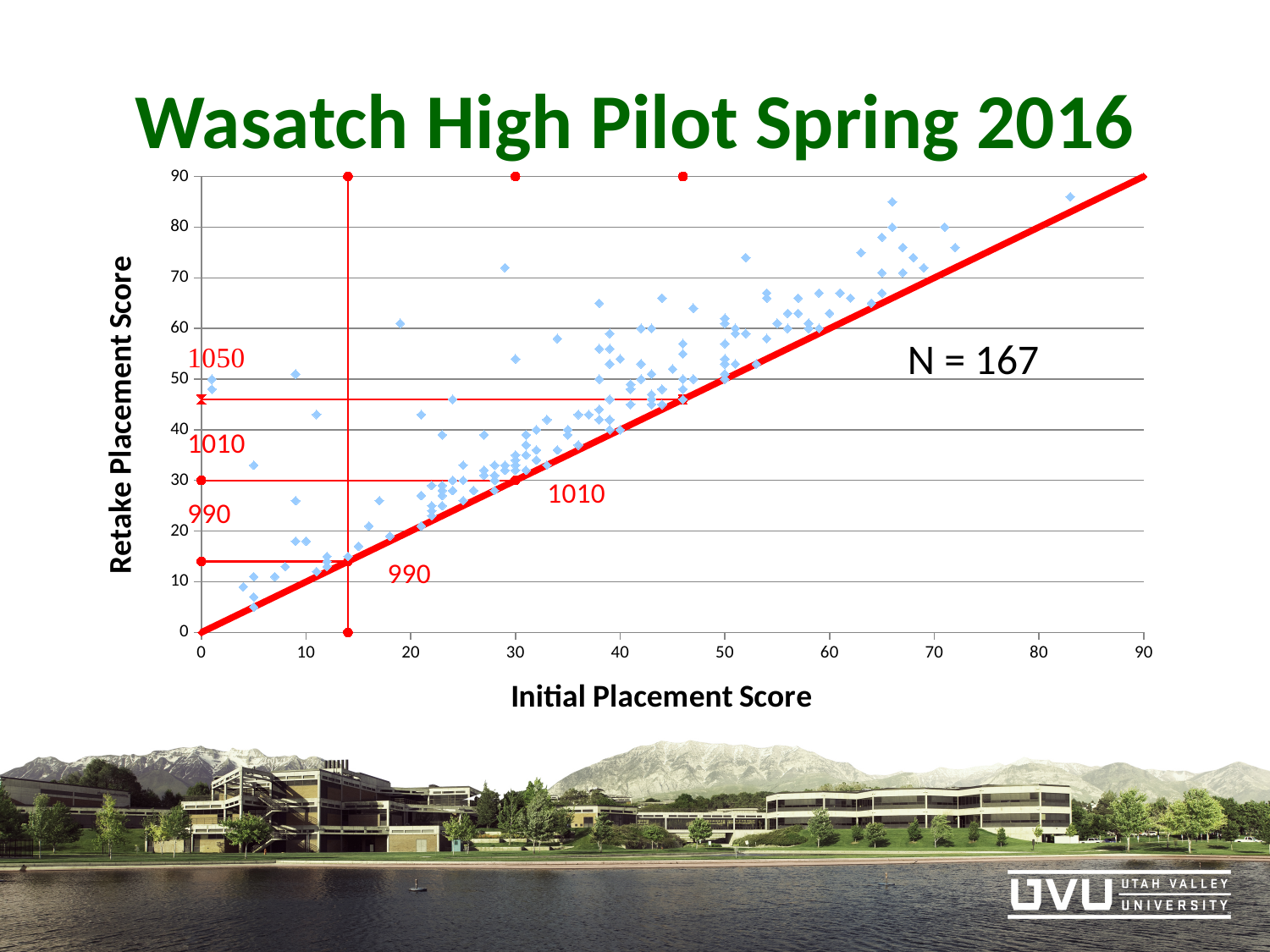
What kind of chart is shown on the slide? Scatter plot What is the title of the chart? Wasatch High Pilot Spring 2016 What is the maximum value shown on the y axis? 90 What is the interval between tick marks on the x axis? 10 Is the highest plotted retake placement score greater or less than 80? greater Is the highest plotted initial placement score greater or less than 80? greater How many data points does the chart report (N)? 167 Do the retake placement scores generally rise or fall as the initial placement score increases? Rise